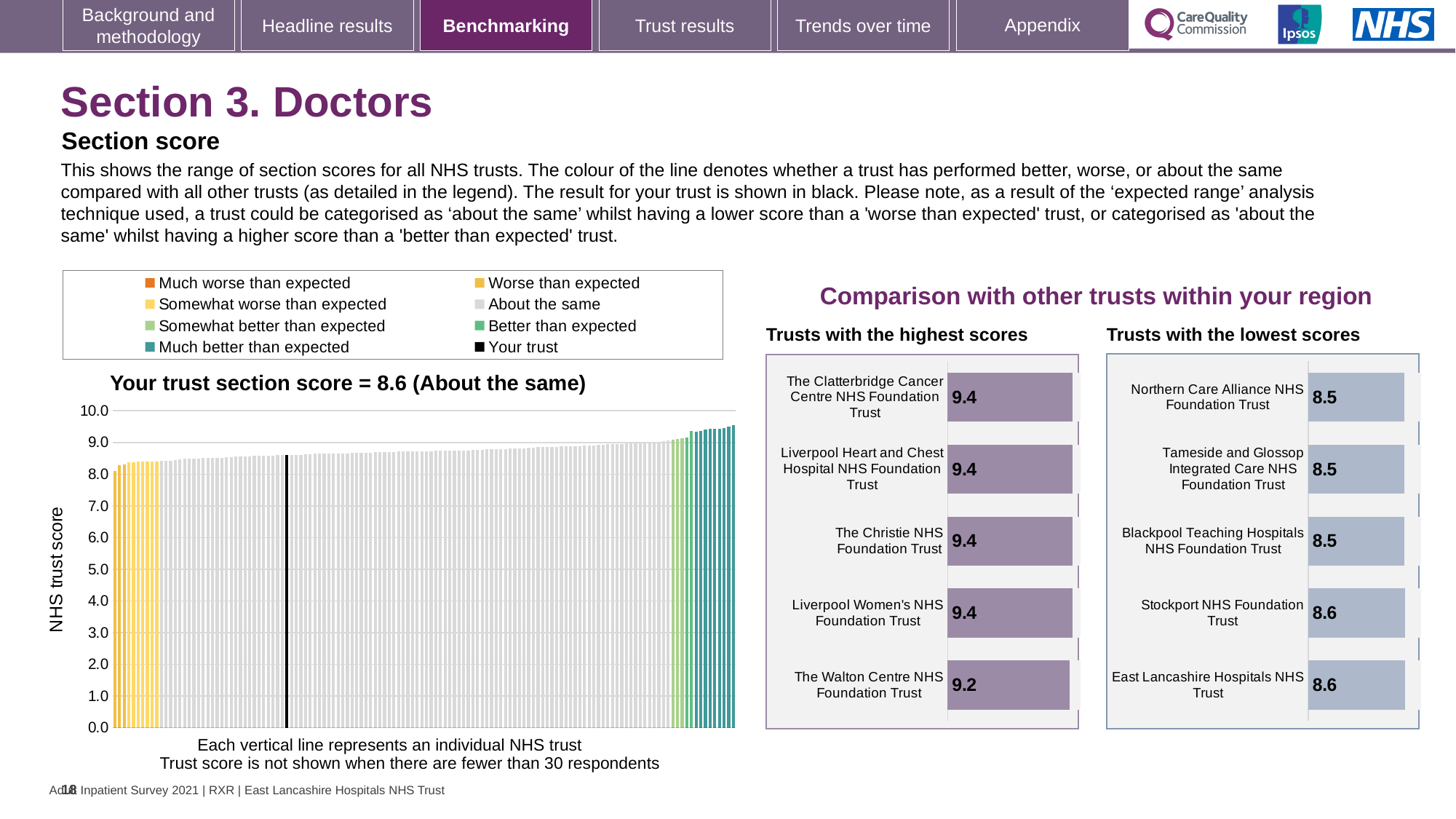
What is the y-axis label of the 'Your trust section score' chart? NHS trust score In the 'Your trust section score' chart, what category is your trust placed in? About the same In the 'Trusts with the lowest scores' chart, what is the score for Blackpool Teaching Hospitals NHS Foundation Trust? 8.5 In the 'Your trust section score' chart, is the value for the lowest-scoring trust greater or less than 7.0? greater In the 'Trusts with the highest scores' chart, what is the score for The Walton Centre NHS Foundation Trust? 9.2 How many entries does the legend above the 'Your trust section score' chart list? 8 In the 'Your trust section score' chart, what is the section score for your trust? 8.6 In the 'Trusts with the highest scores' chart, which trust has the lowest score? The Walton Centre NHS Foundation Trust In the 'Trusts with the highest scores' chart, what is the difference between the score for The Christie NHS Foundation Trust and The Walton Centre NHS Foundation Trust? 0.2 How many trusts are shown in the 'Trusts with the lowest scores' chart? 5 In the 'Trusts with the lowest scores' chart, which has the larger score: Stockport NHS Foundation Trust or Northern Care Alliance NHS Foundation Trust? Stockport NHS Foundation Trust What kind of chart is the 'Your trust section score' chart? bar chart